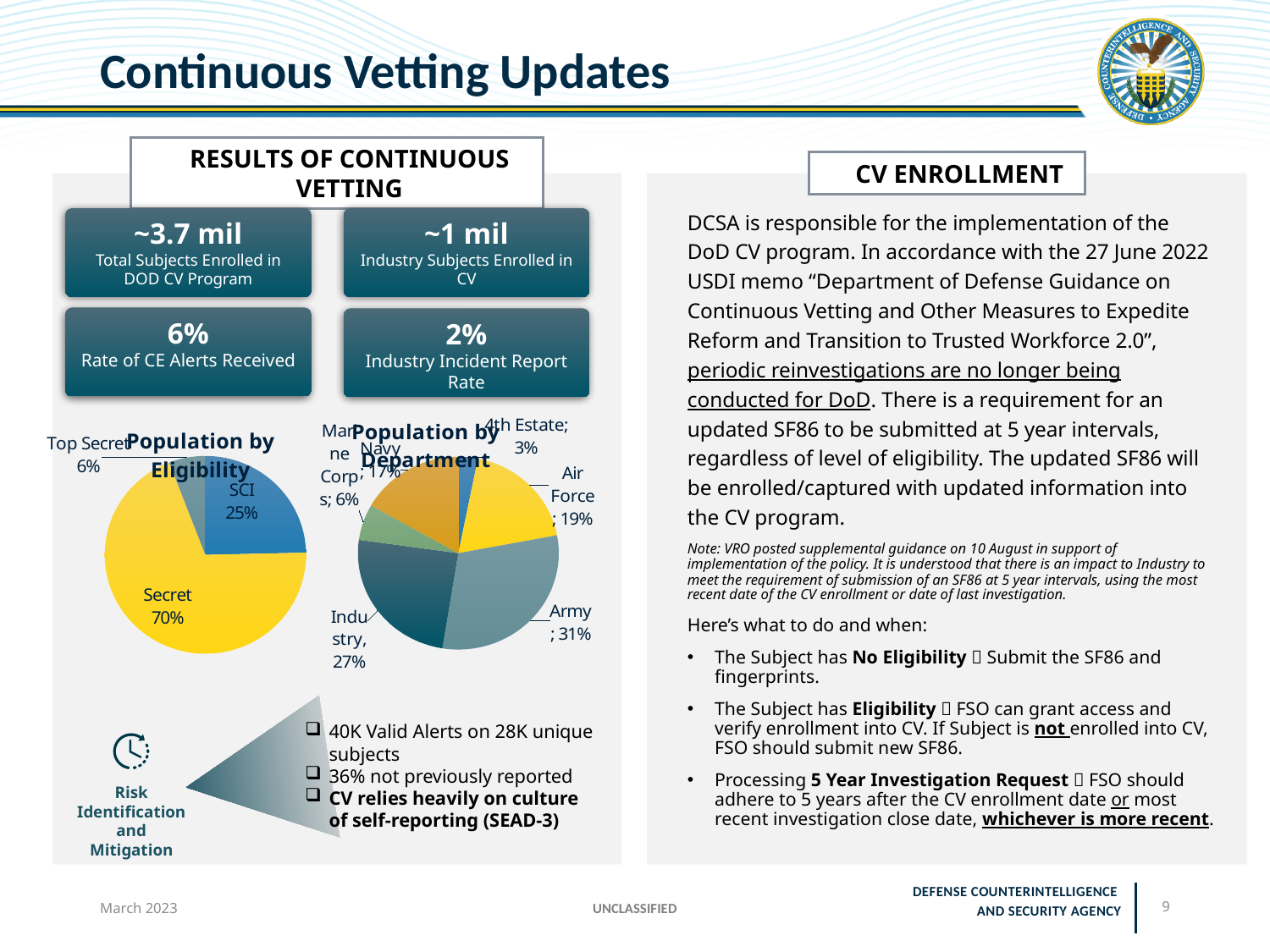
In the Population by Eligibility chart, which eligibility level has the smallest share? Top Secret In the Population by Eligibility chart, what share of the population is Secret? 70% In the Population by Eligibility chart, how many slices does the pie have? 3 In the Population by Department chart, which department has the smallest share? 4th Estate In the Population by Department chart, what is the difference between the Army share and the Industry share? 4% In the Population by Eligibility chart, what share of the population is SCI? 25% In the Population by Department chart, how many departments are shown? 6 In the Population by Department chart, what share of the population is Army? 31% In the Population by Department chart, which department has the largest share? Army What kind of chart is the Population by Eligibility chart? Pie chart In the Population by Department chart, which is larger, Industry or Navy? Industry In the Population by Department chart, what share of the population is Air Force? 19%